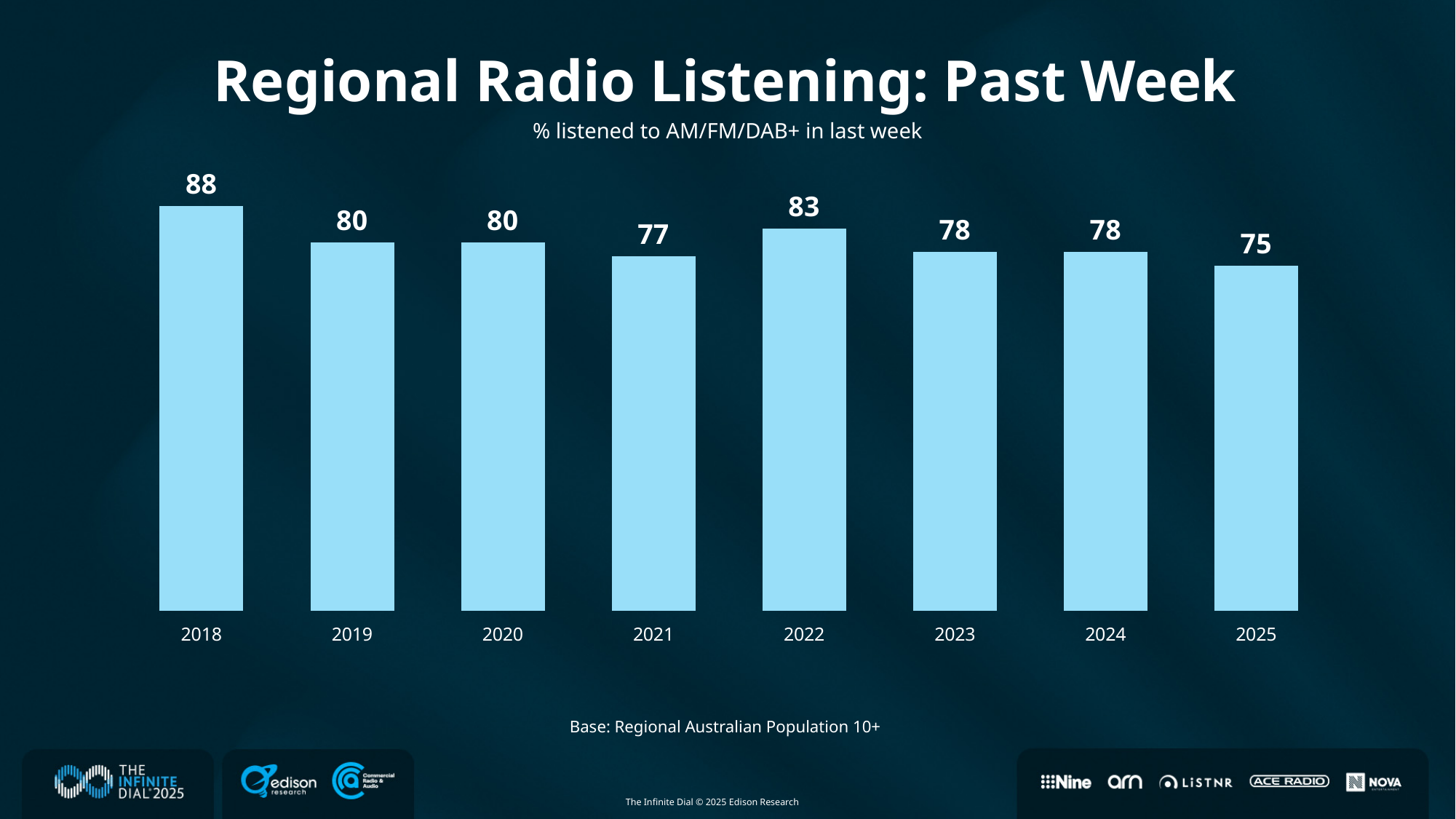
What is the value for 2025? 75 Which year has the lowest value? 2025 How many years are shown on the chart? 8 What is the difference between the values for 2022 and 2023? 5 What is the value for 2018? 88 What is the title of the chart? Regional Radio Listening: Past Week Which year has the highest value? 2018 What is the difference between the values for 2018 and 2025? 13 Which is larger, the value for 2022 or the value for 2021? 2022 What is the value for 2022? 83 What is the value for 2021? 77 What kind of chart is shown on the slide? Bar chart